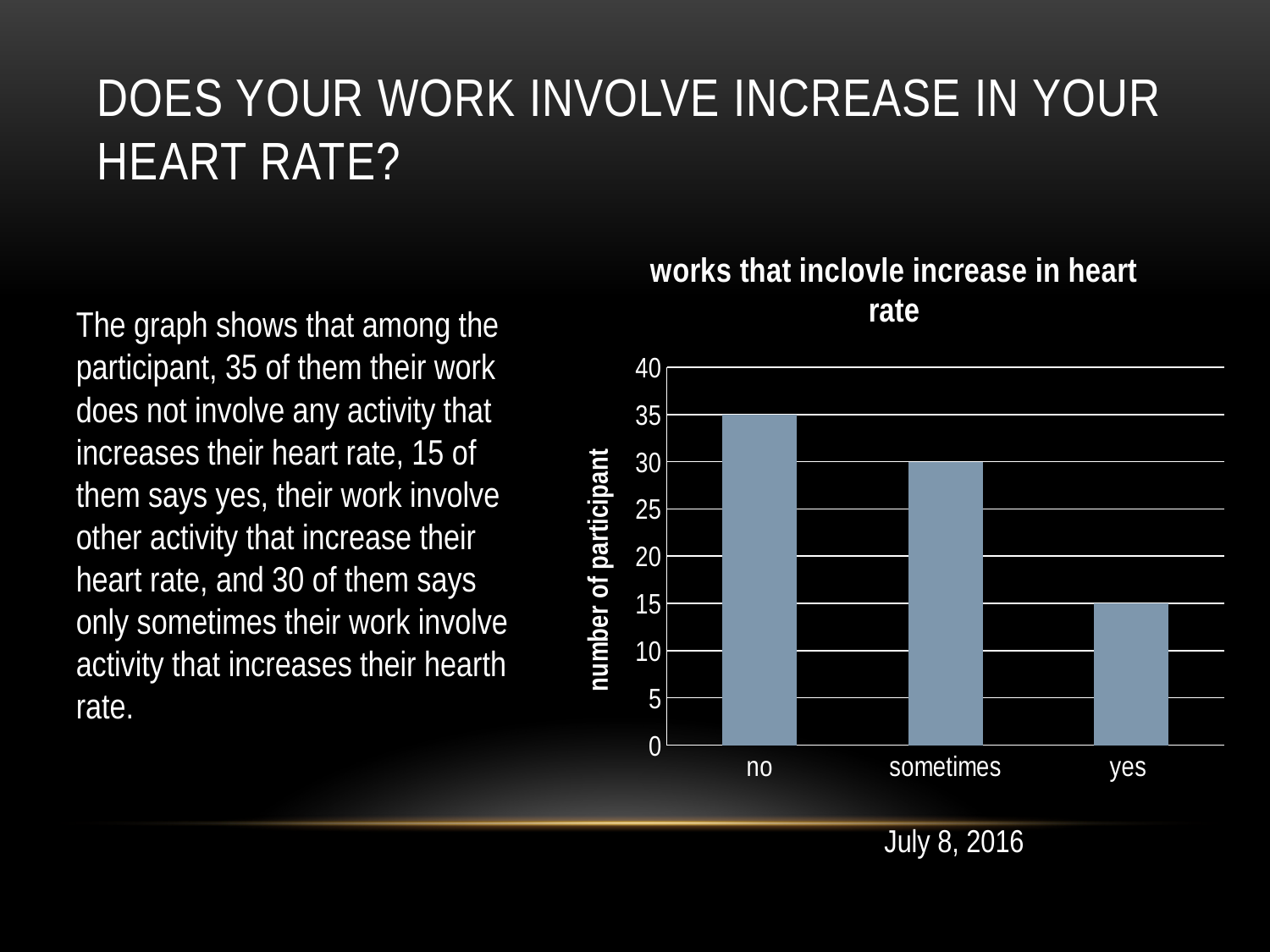
What is the number of participants for the "yes" category? 15 Which category has the lowest number of participants? yes What is the number of participants for the "no" category? 35 How many categories are shown on the x axis of the chart? 3 What is the label of the vertical axis of the chart? number of participant What kind of chart is shown on the slide? bar chart Which category has the highest number of participants? no What is the number of participants for the "sometimes" category? 30 Which has more participants, "sometimes" or "yes"? sometimes Is the value for "sometimes" greater or less than 20? greater What is the difference in number of participants between "sometimes" and "yes"? 15 What is the difference in number of participants between "no" and "yes"? 20